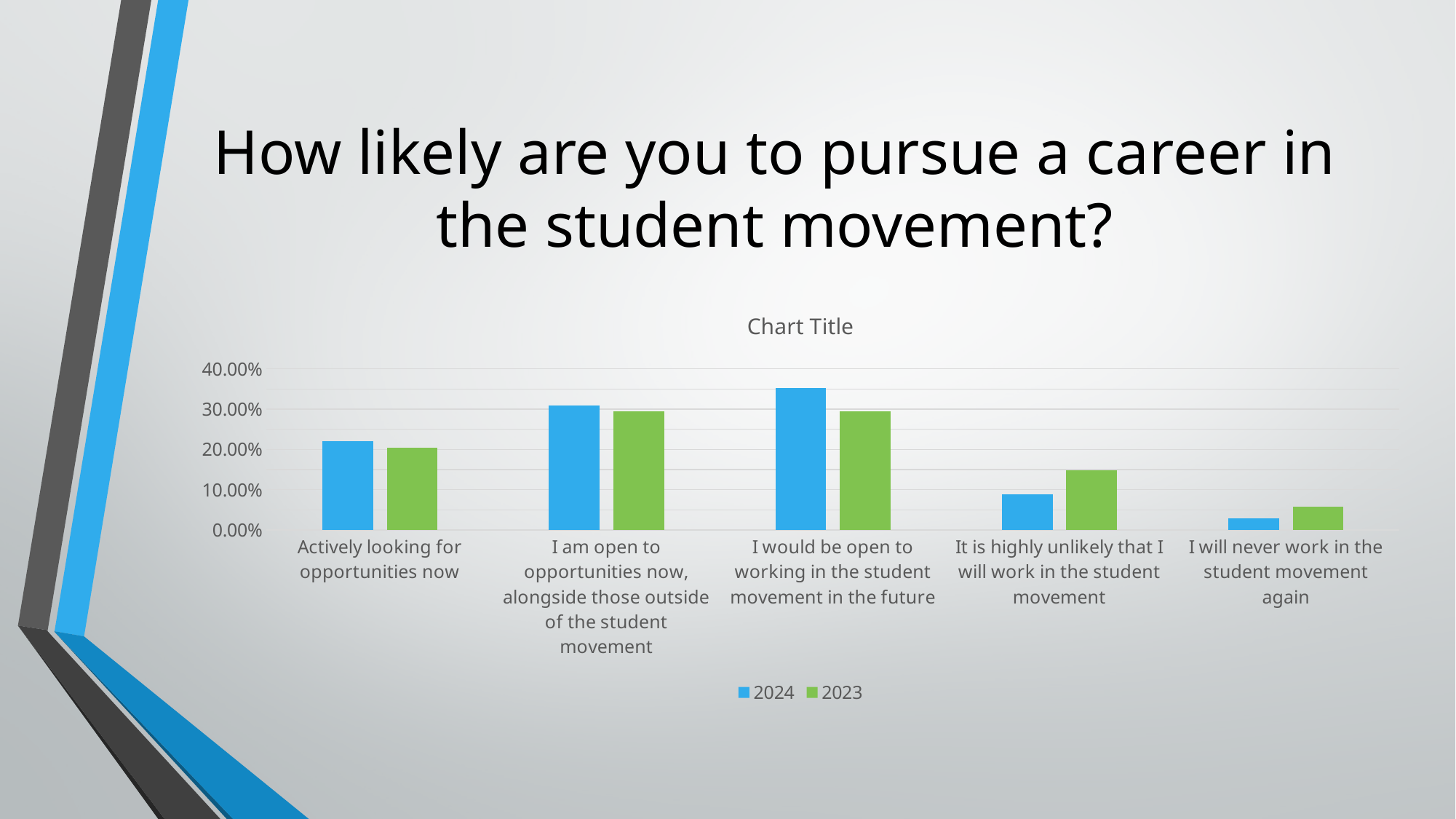
For 'I would be open to working in the student movement in the future', which series has the larger value, 2024 or 2023? 2024 For 'It is highly unlikely that I will work in the student movement', which series has the larger value, 2024 or 2023? 2023 Which category has the lowest value for the 2023 series? I will never work in the student movement again How many series does the legend list? 2 What kind of chart is shown on the slide? bar chart What colour are the bars for the 2023 series? green Is the 2024 value for 'It is highly unlikely that I will work in the student movement' greater or less than 10.00%? less Is the 2023 value for 'It is highly unlikely that I will work in the student movement' greater or less than 10.00%? greater Which category has the highest value for the 2024 series? I would be open to working in the student movement in the future Which category has the lowest value for the 2024 series? I will never work in the student movement again Is the 2024 value for 'I would be open to working in the student movement in the future' greater or less than 30.00%? greater How many categories are shown on the x axis? 5